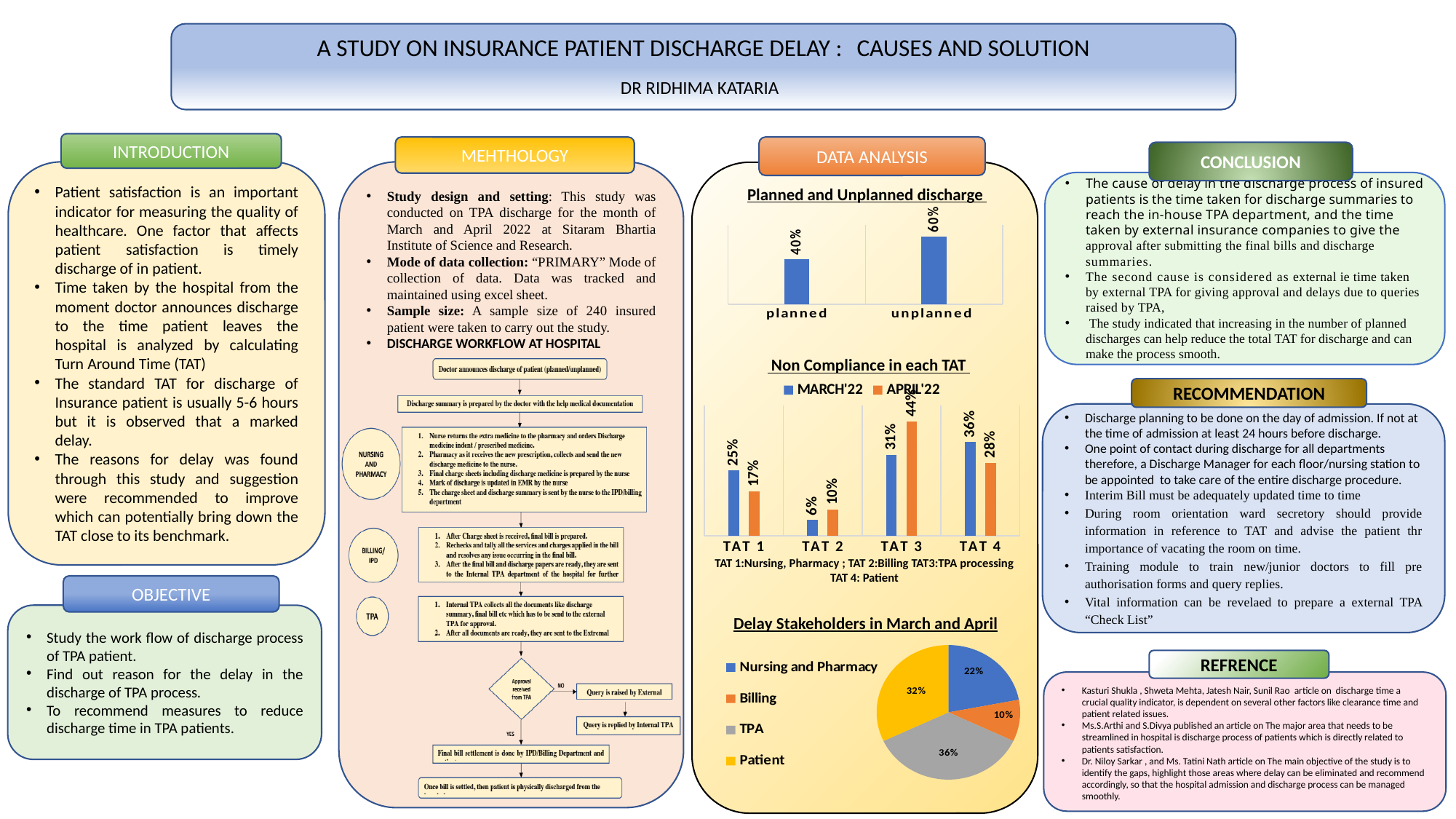
In the 'Non Compliance in each TAT' chart, what is the difference between the APRIL'22 and MARCH'22 values for TAT 3? 13% In the 'Non Compliance in each TAT' chart, which TAT has the lowest MARCH'22 value? TAT 2 In the 'Non Compliance in each TAT' chart, what is the APRIL'22 value for TAT 2? 10% In the 'Non Compliance in each TAT' chart, what is the MARCH'22 value for TAT 3? 31% What kind of chart is the 'Planned and Unplanned discharge' chart? bar chart In the 'Planned and Unplanned discharge' chart, what is the value for unplanned? 60% In the 'Delay Stakeholders in March and April' pie chart, what share does TPA have? 36% In the 'Non Compliance in each TAT' chart, how many series does the legend list? 2 In the 'Planned and Unplanned discharge' chart, what is the difference between the unplanned and planned values? 20% In the 'Delay Stakeholders in March and April' pie chart, which stakeholder has the smallest slice? Billing In the 'Non Compliance in each TAT' chart, is the MARCH'22 value for TAT 4 larger or smaller than the APRIL'22 value for TAT 4? larger In the 'Non Compliance in each TAT' chart, which TAT has the highest APRIL'22 value? TAT 3